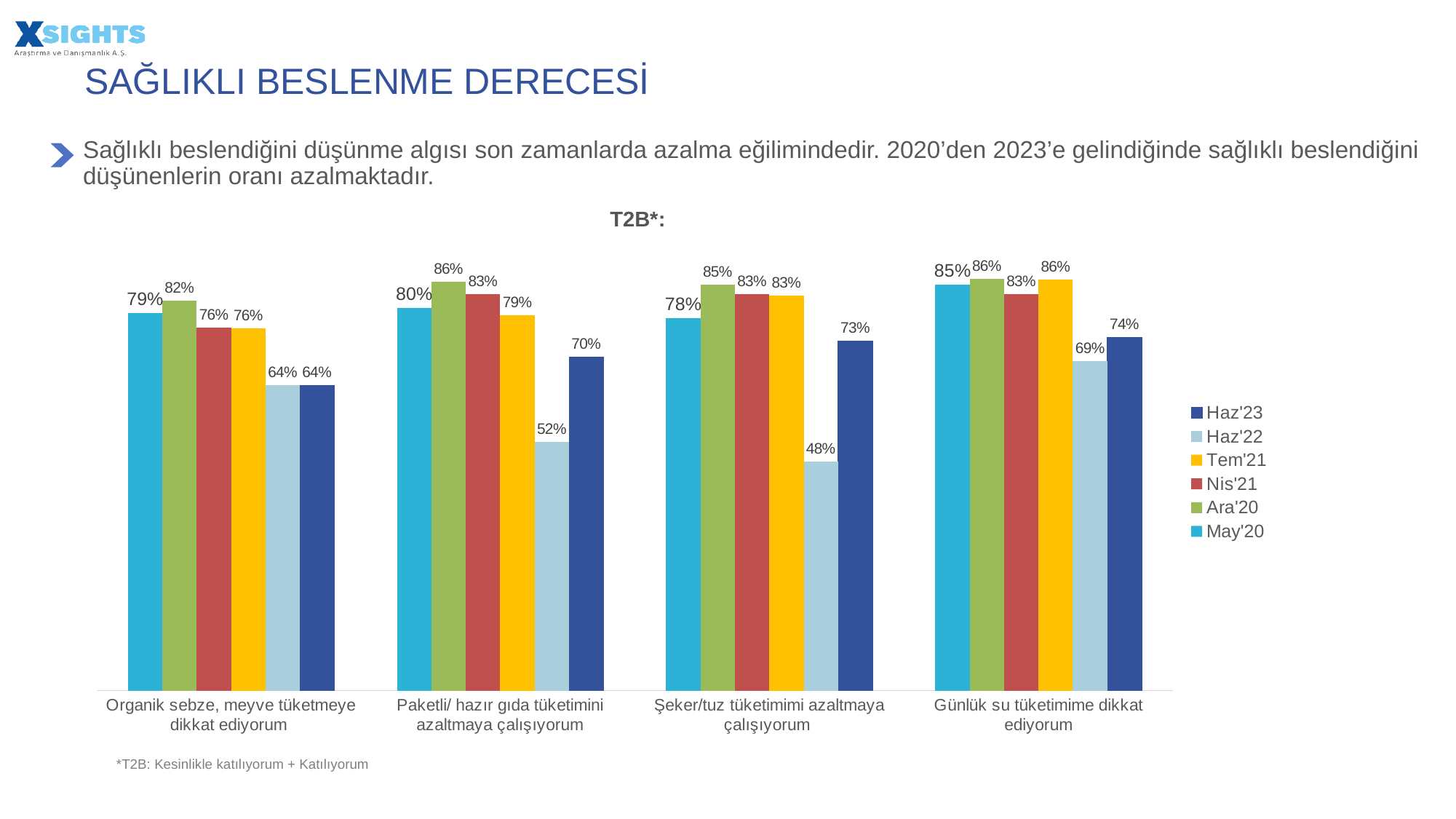
What is the difference between the Ara'20 and Haz'22 values for "Şeker/tuz tüketimimi azaltmaya çalışıyorum"? 37% How many categories are shown on the x axis of the chart? 4 What is the Haz'23 value for "Şeker/tuz tüketimimi azaltmaya çalışıyorum"? 73% What is the title of the chart? T2B*: What is the May'20 value for "Günlük su tüketimime dikkat ediyorum"? 85% What kind of chart is shown on the slide? Bar chart For "Paketli/ hazır gıda tüketimini azaltmaya çalışıyorum", which is larger: the Haz'23 value or the Haz'22 value? Haz'23 What is the Ara'20 value for "Organik sebze, meyve tüketmeye dikkat ediyorum"? 82% How many series does the legend list? 6 Which category has the highest Haz'23 value? Günlük su tüketimime dikkat ediyorum What is the Haz'22 value for "Paketli/ hazır gıda tüketimini azaltmaya çalışıyorum"? 52% Which category has the lowest Haz'22 value? Şeker/tuz tüketimimi azaltmaya çalışıyorum